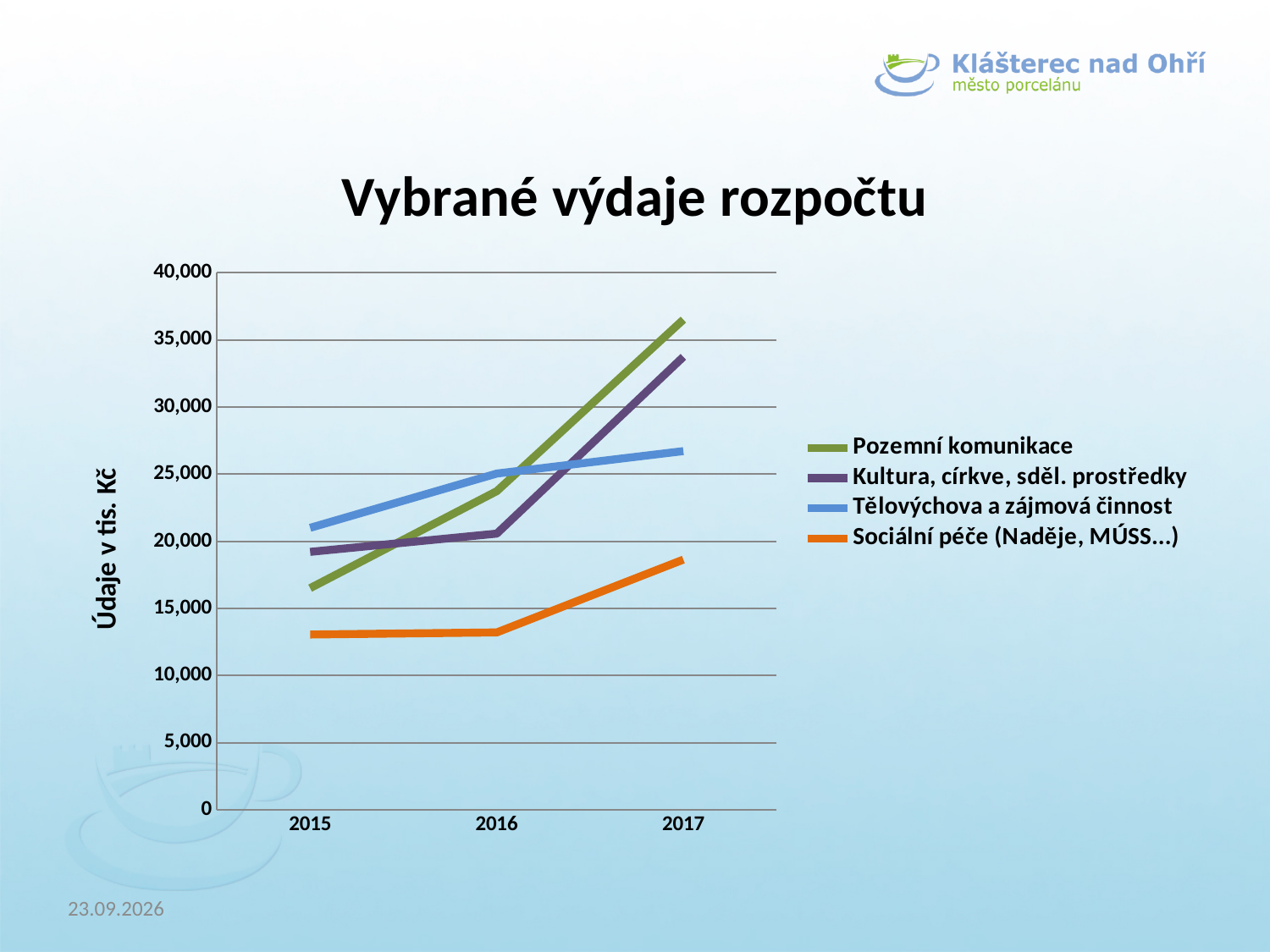
How many years are shown on the x axis? 3 Is the value for Kultura, církve, sděl. prostředky in 2017 greater or less than 30,000? greater In 2016, which is larger: Tělovýchova a zájmová činnost or Kultura, církve, sděl. prostředky? Tělovýchova a zájmová činnost Which series has the highest value in 2015? Tělovýchova a zájmová činnost Is the value for Pozemní komunikace in 2017 greater or less than 35,000? greater Which series has the lowest value in 2017? Sociální péče (Naděje, MÚSS...) Does the value for Pozemní komunikace rise or fall from 2015 to 2017? rise Is the value for Sociální péče (Naděje, MÚSS...) in 2015 greater or less than 15,000? less What kind of chart is shown on the slide? line chart What is the title of the y axis? Údaje v tis. Kč How many series does the legend list? 4 Which series has the highest value in 2017? Pozemní komunikace